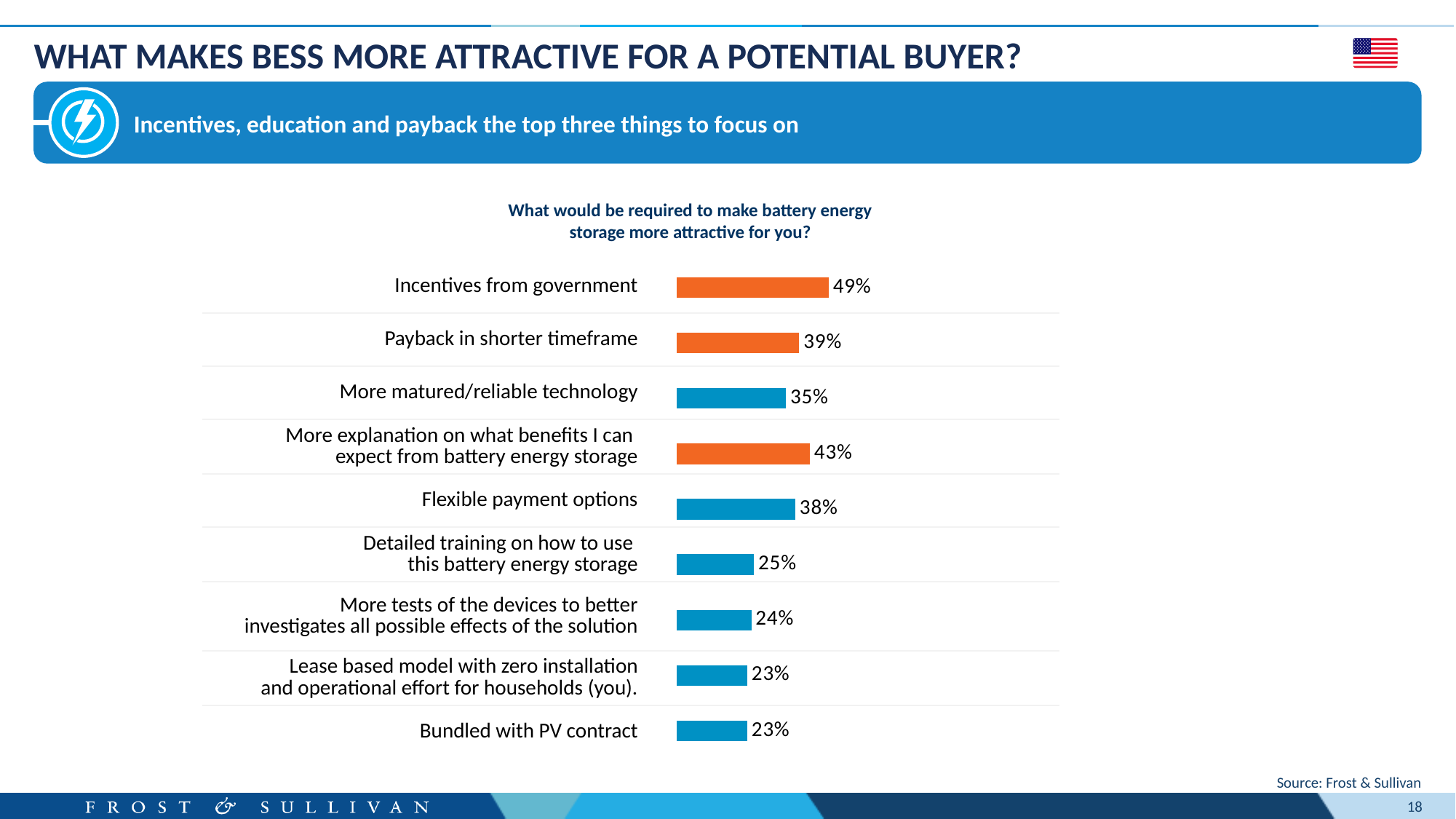
What is the value for Incentives from government? 49% What is the difference between Detailed training on how to use this battery energy storage and More tests of the devices to better investigates all possible effects of the solution? 1% Which is larger: More explanation on what benefits I can expect from battery energy storage or Flexible payment options? More explanation on what benefits I can expect from battery energy storage What kind of chart is shown on the slide? Bar chart What is the value for Bundled with PV contract? 23% How many bars are coloured orange? 3 What is the title of the chart? What would be required to make battery energy storage more attractive for you? Which category has the highest value? Incentives from government What is the value for More matured/reliable technology? 35% What is the value for Flexible payment options? 38% How many categories are shown in the chart? 9 What is the difference between Incentives from government and Payback in shorter timeframe? 10%